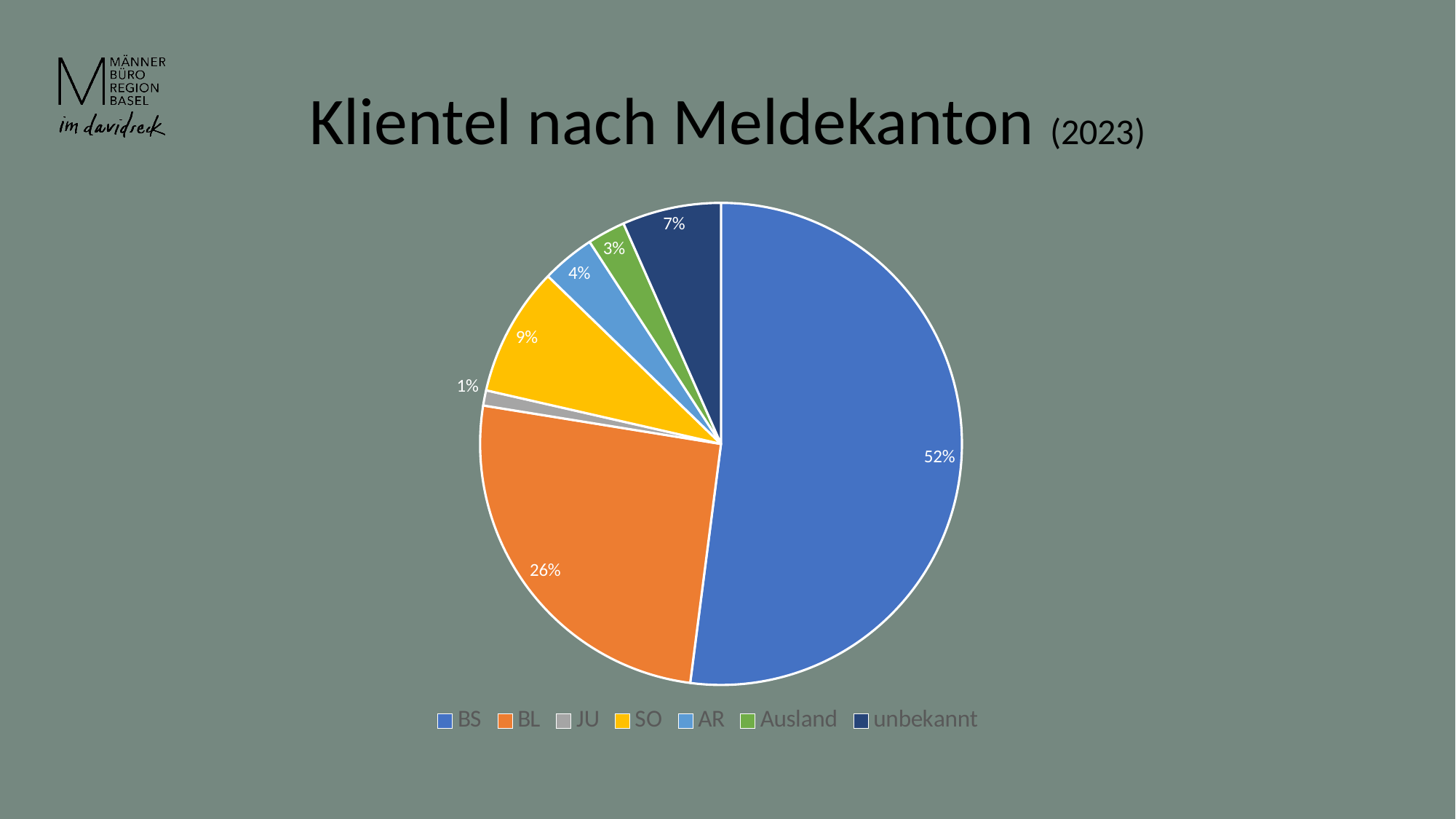
What is the title of the chart? Klientel nach Meldekanton (2023) Which is larger, the slice for AR or the slice for Ausland? AR What share of the pie does JU have? 1% What share of the pie does unbekannt have? 7% What kind of chart is shown on the slide? pie chart Which category has the largest slice of the pie? BS What share of the pie does BS have? 52% What is the difference in percentage points between BS and BL? 26 How many categories does the legend list? 7 Which category has the smallest slice of the pie? JU